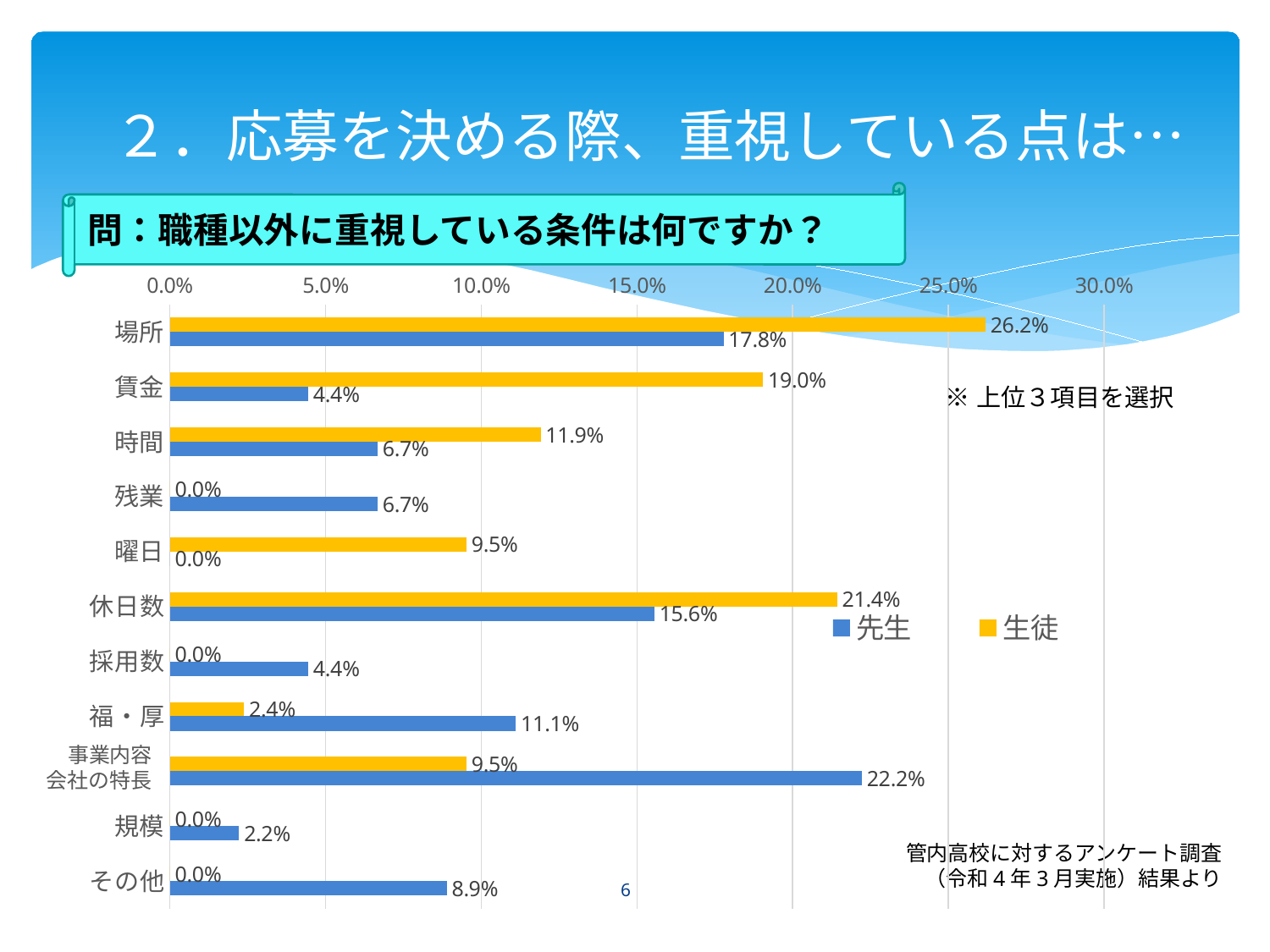
How many series does the legend list? 2 Which category has the highest 生徒 value? 場所 How many categories are shown on the chart? 11 What is the 生徒 value for 場所? 26.2% Which colour represents the 生徒 series? Yellow What is the 先生 value for 事業内容会社の特長? 22.2% What kind of chart is shown on the slide? Bar chart For 福・厚, which is larger, the 先生 value or the 生徒 value? 先生 Which category has the highest 先生 value? 事業内容会社の特長 What is the difference between the 生徒 and 先生 values for 賃金? 14.6% What is the 先生 value for 賃金? 4.4% Is the 先生 value for 休日数 greater or less than 10.0%? greater